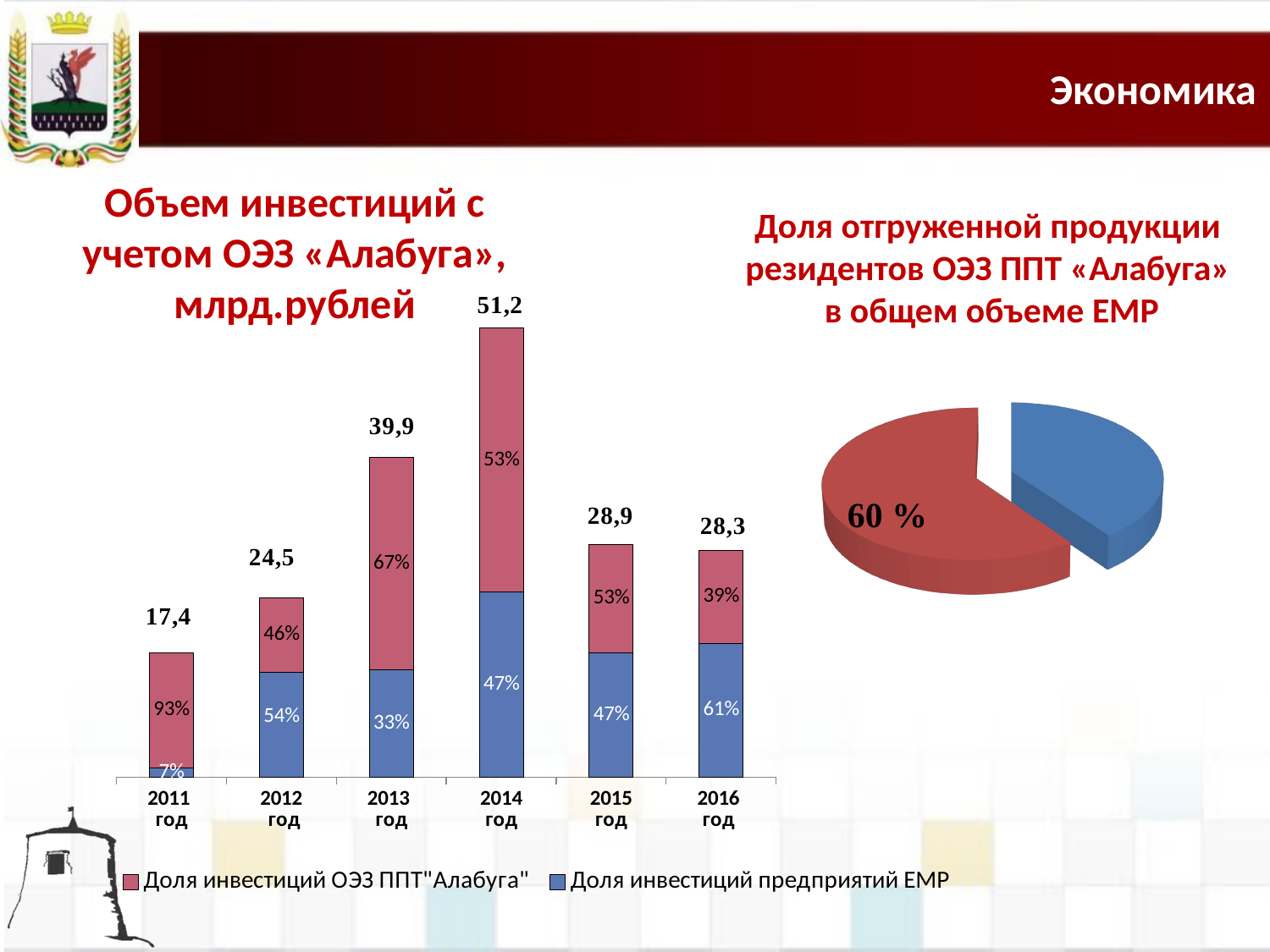
On the bar chart 'Объем инвестиций с учетом ОЭЗ «Алабуга», млрд.рублей', what is the difference between the total values for 2014 год and 2013 год? 11,3 How many series does the legend of the bar chart 'Объем инвестиций с учетом ОЭЗ «Алабуга», млрд.рублей' list? 2 On the pie chart 'Доля отгруженной продукции резидентов ОЭЗ ППТ «Алабуга» в общем объеме ЕМР', what share is labelled on the red slice? 60 % On the bar chart 'Объем инвестиций с учетом ОЭЗ «Алабуга», млрд.рублей', what percentage is labelled on the 'Доля инвестиций ОЭЗ ППТ"Алабуга"' segment for 2013 год? 67% What kind of chart is the chart on the right titled 'Доля отгруженной продукции резидентов ОЭЗ ППТ «Алабуга» в общем объеме ЕМР'? Pie chart On the bar chart 'Объем инвестиций с учетом ОЭЗ «Алабуга», млрд.рублей', which year has the larger total value, 2015 год or 2016 год? 2015 год On the bar chart 'Объем инвестиций с учетом ОЭЗ «Алабуга», млрд.рублей', what is the total value shown above the bar for 2014 год? 51,2 On the bar chart 'Объем инвестиций с учетом ОЭЗ «Алабуга», млрд.рублей', what percentage is labelled on the 'Доля инвестиций предприятий ЕМР' segment for 2016 год? 61% How many years are shown on the x axis of the bar chart 'Объем инвестиций с учетом ОЭЗ «Алабуга», млрд.рублей'? 6 On the bar chart 'Объем инвестиций с учетом ОЭЗ «Алабуга», млрд.рублей', what is the total value shown above the bar for 2011 год? 17,4 On the bar chart 'Объем инвестиций с учетом ОЭЗ «Алабуга», млрд.рублей', which year has the lowest total value? 2011 год On the bar chart 'Объем инвестиций с учетом ОЭЗ «Алабуга», млрд.рублей', which year has the highest total value? 2014 год